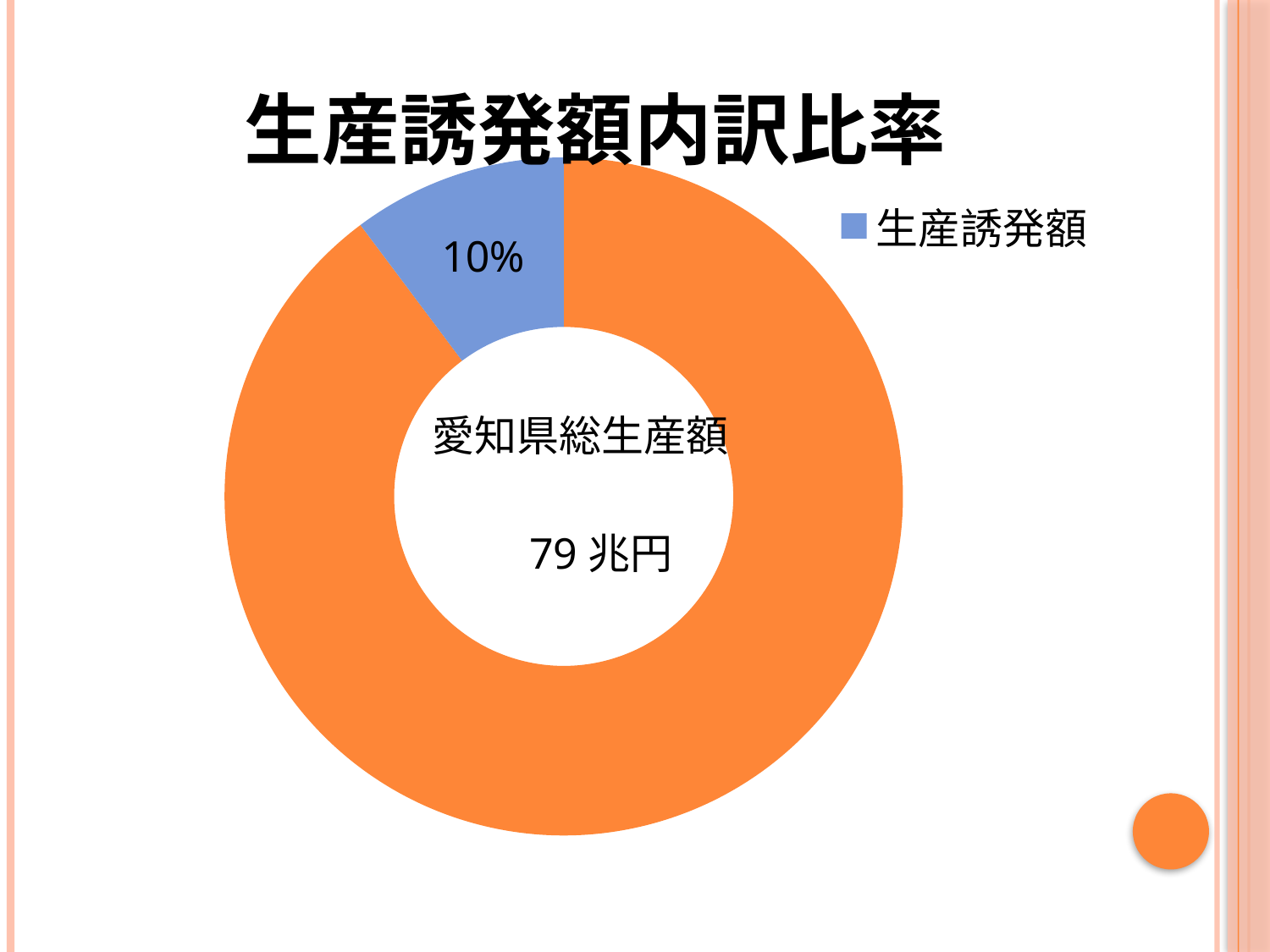
Which slice is the smallest in the chart? 生産誘発額 What kind of chart is shown on the slide? Doughnut (pie) chart How many entries does the legend list? 1 What share of the doughnut does the 生産誘発額 slice represent? 10% Which slice is larger, the blue 生産誘発額 slice or the orange slice? The orange slice How many slices does the doughnut chart have? 2 What is the title of the chart? 生産誘発額内訳比率 What colour is used for the 生産誘発額 slice? Blue